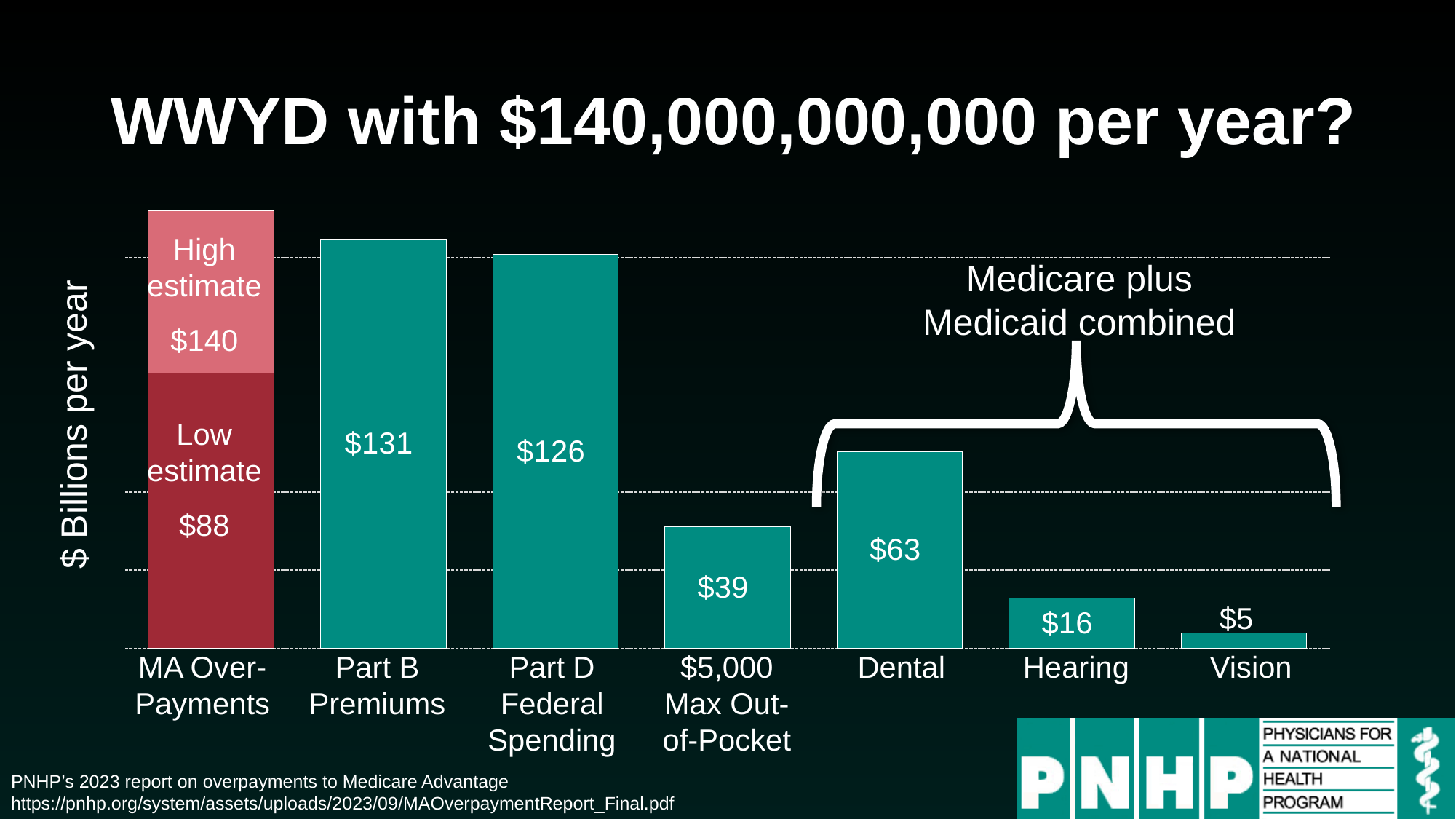
What is the high estimate for MA Over-Payments? $140 What is the low estimate for MA Over-Payments? $88 Which category has the lowest value? Vision What is the value for Vision? $5 Which is larger, Dental or $5,000 Max Out-of-Pocket? Dental How many categories are shown on the x axis? 7 What is the y-axis label of the chart? $ Billions per year What is the difference between Dental and Hearing? $47 What kind of chart is this? Bar chart What is the value for Part B Premiums? $131 What is the difference between Part B Premiums and Part D Federal Spending? $5 What is the value for Dental? $63